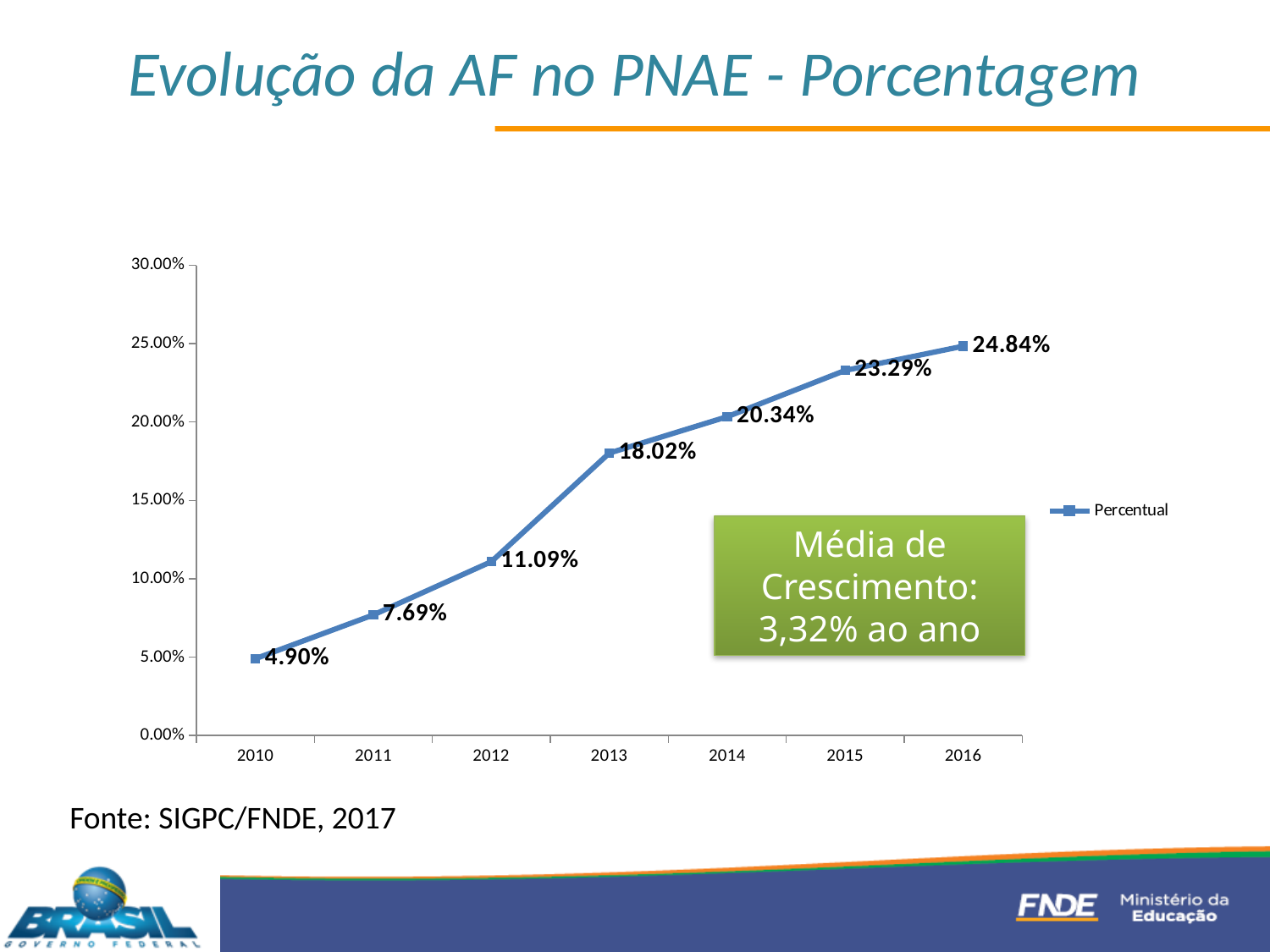
What is the value for 2016? 24.84% How many years are plotted on the chart? 7 Is the value for 2015 greater or less than 20.00%? greater What is the value for 2010? 4.90% What is the value for 2013? 18.02% Which year has the highest value? 2016 What is the difference between the values for 2013 and 2012? 6.93% Do the values rise or fall from 2010 to 2016? rise Which year has the lowest value? 2010 Which is larger, the value for 2014 or the value for 2011? 2014 What kind of chart is shown on the slide? line chart What is the difference between the values for 2016 and 2010? 19.94%